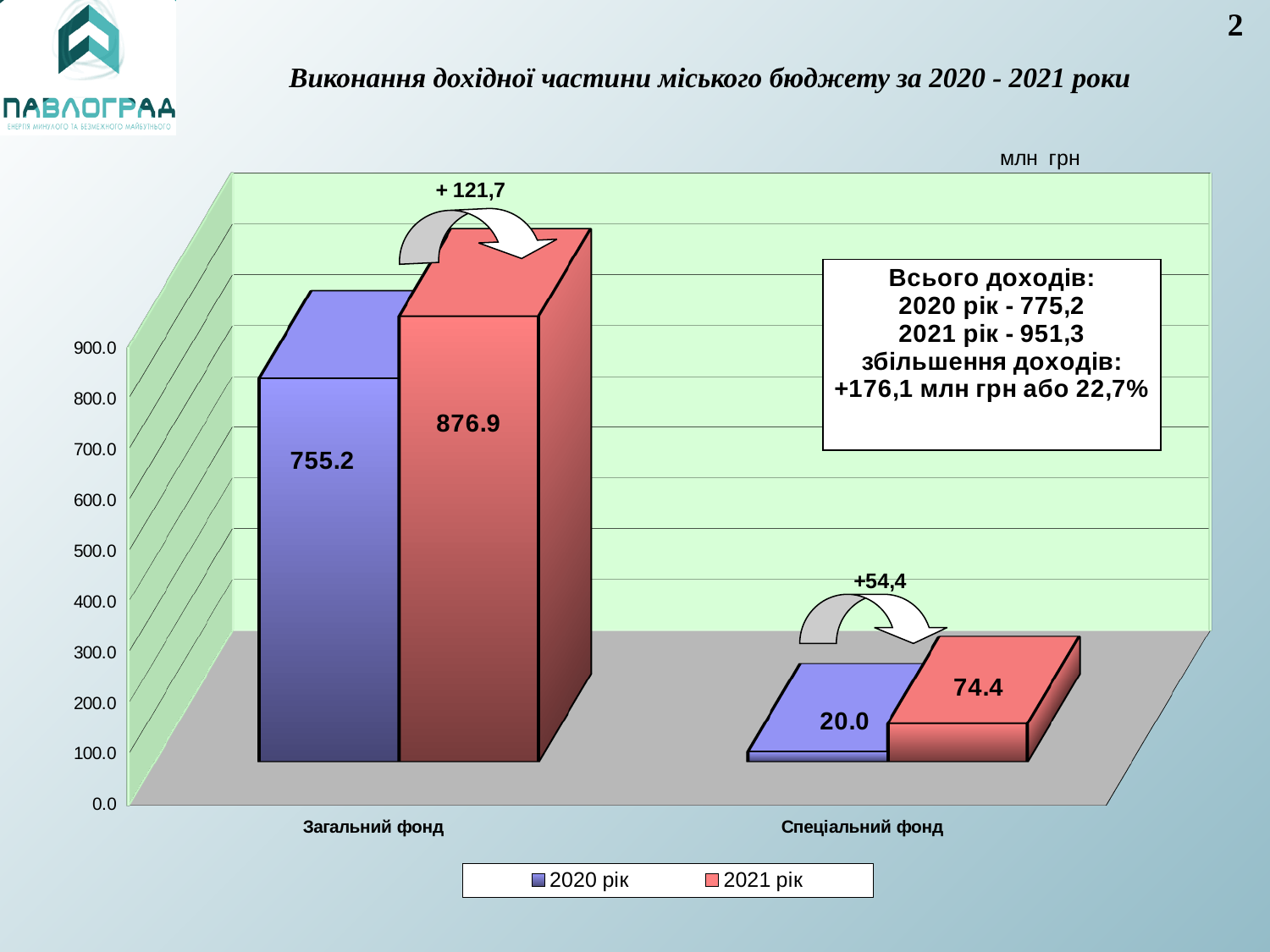
How many series does the legend list? 2 Which bar has the highest value on the chart? 2021 рік, Загальний фонд Which is larger for Спеціальний фонд: the 2020 рік value or the 2021 рік value? 2021 рік What is the difference between the 2021 рік and 2020 рік values for Спеціальний фонд? 54.4 Which bar has the lowest value on the chart? 2020 рік, Спеціальний фонд What kind of chart is shown on the slide? Bar chart What is the difference between the 2021 рік and 2020 рік values for Загальний фонд? 121.7 What is the value for 2020 рік in the Загальний фонд category? 755.2 What is the value for 2021 рік in the Спеціальний фонд category? 74.4 What is the value for 2020 рік in the Спеціальний фонд category? 20.0 How many categories are shown on the x axis? 2 What is the value for 2021 рік in the Загальний фонд category? 876.9